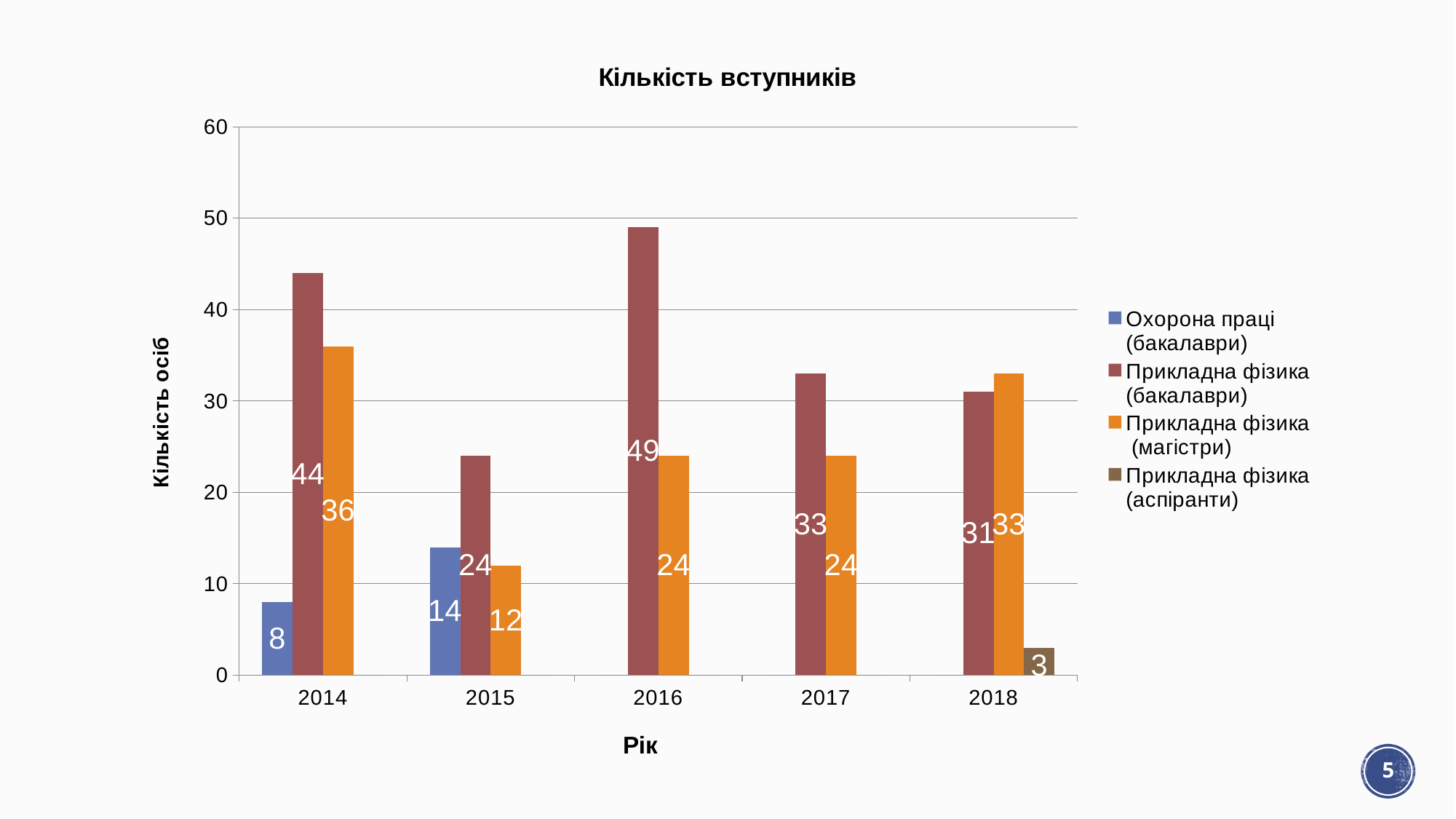
What kind of chart is shown on the slide? bar chart What is the value for Прикладна фізика (аспіранти) in 2018? 3 In which year is the value for Прикладна фізика (бакалаври) highest? 2016 What is the value for Прикладна фізика (бакалаври) in 2016? 49 What is the value for Охорона праці (бакалаври) in 2015? 14 In 2018, which is larger: Прикладна фізика (бакалаври) or Прикладна фізика (магістри)? Прикладна фізика (магістри) What is the difference between Прикладна фізика (бакалаври) and Прикладна фізика (магістри) in 2016? 25 How many years are shown on the x axis? 5 Is the value for Прикладна фізика (бакалаври) in 2014 greater or less than 40? greater What is the value for Прикладна фізика (магістри) in 2014? 36 How many series does the legend list? 4 In which year is the value for Прикладна фізика (магістри) lowest? 2015